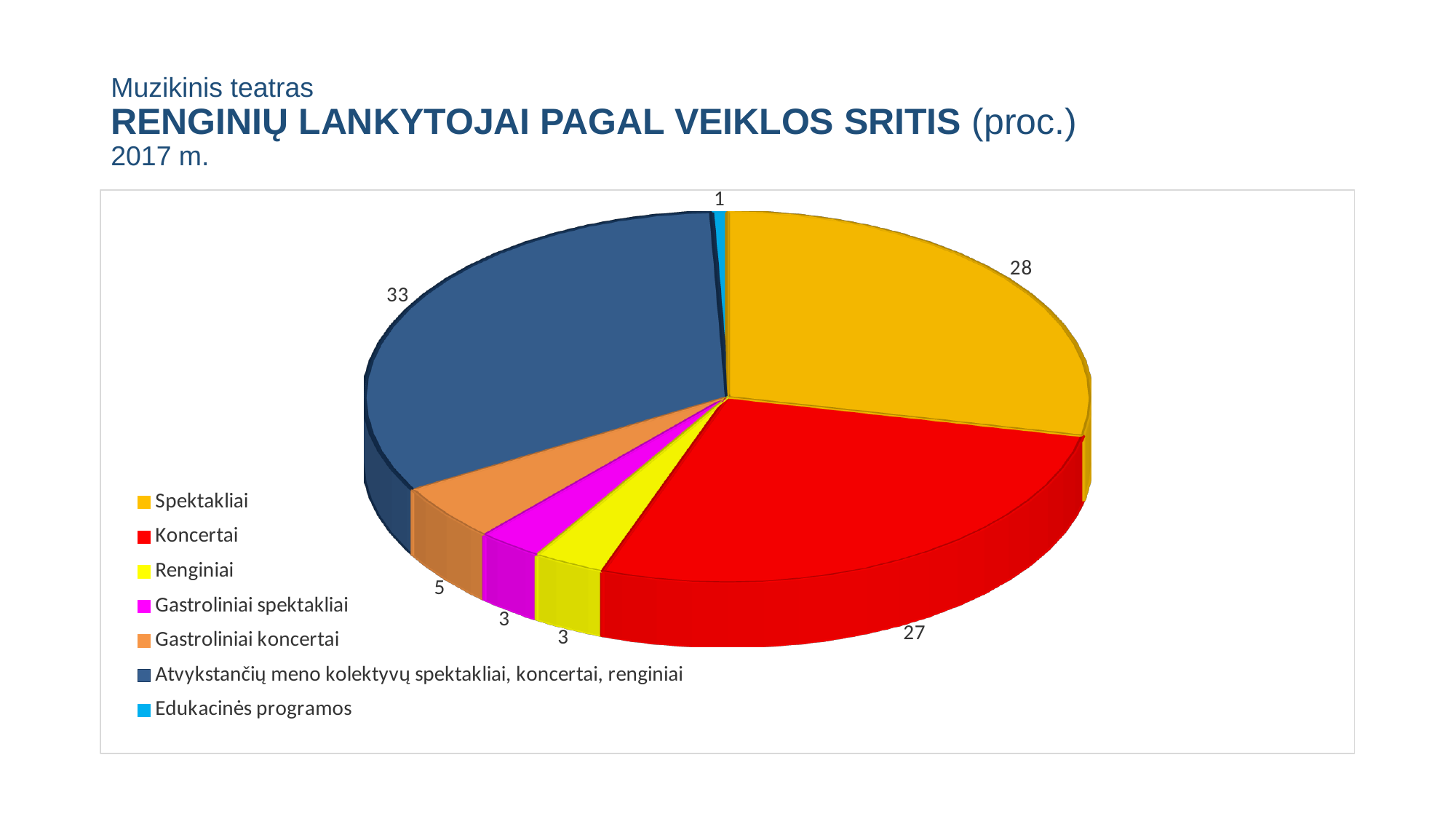
Which category has the largest share of the pie? Atvykstančių meno kolektyvų spektakliai, koncertai, renginiai How many categories does the pie chart show? 7 What is the value for Koncertai? 27 Which year does the chart title refer to? 2017 m. Which category has the smallest share of the pie? Edukacinės programos Which is larger, the value for Gastroliniai koncertai or the value for Renginiai? Gastroliniai koncertai What is the value for Edukacinės programos? 1 What is the difference between the values for Atvykstančių meno kolektyvų spektakliai, koncertai, renginiai and Spektakliai? 5 What is the value for Atvykstančių meno kolektyvų spektakliai, koncertai, renginiai? 33 What kind of chart is shown on the slide? Pie chart What is the value for Spektakliai? 28 What is the value for Gastroliniai koncertai? 5